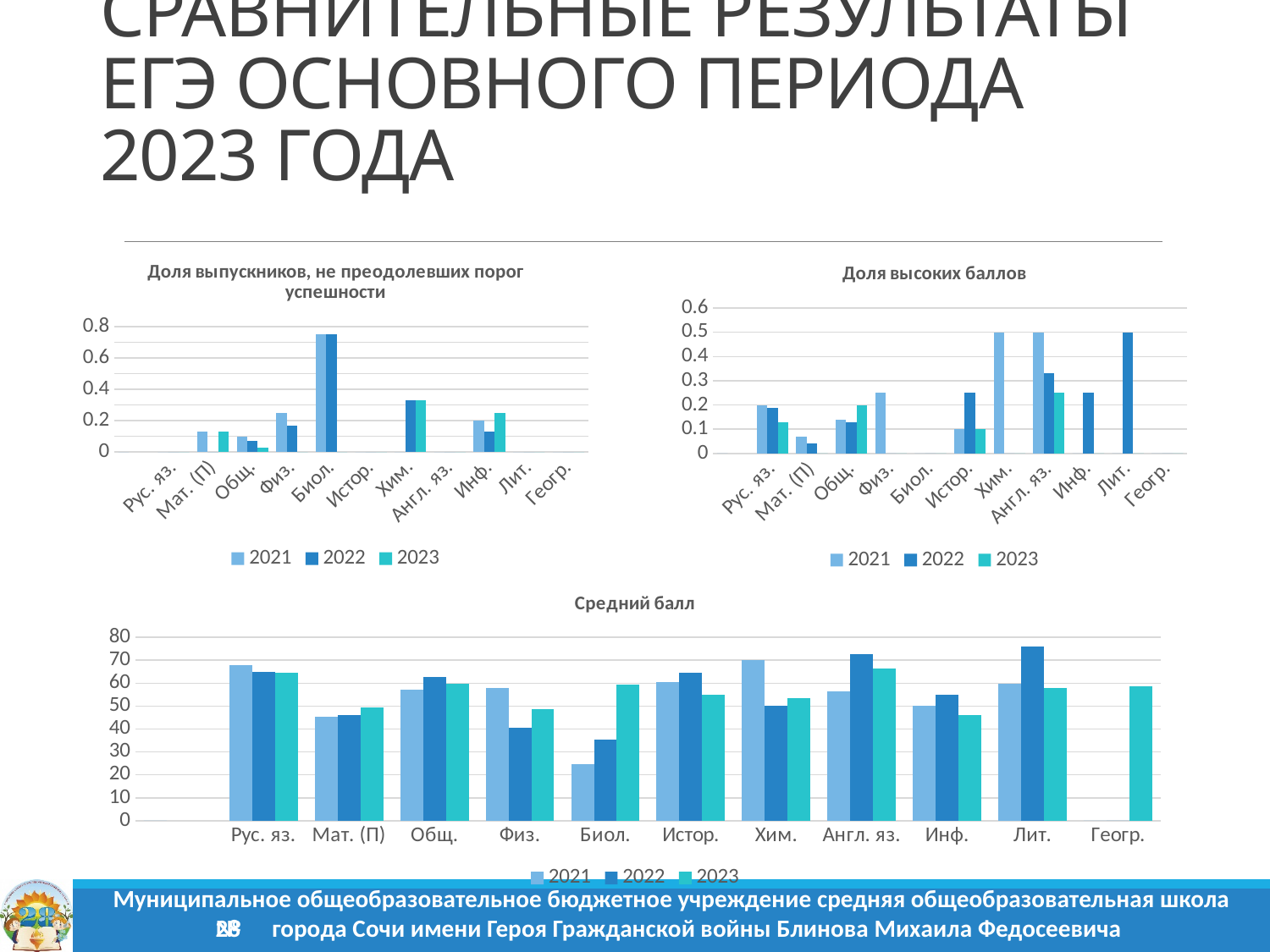
In the "Средний балл" chart, which subject has the lowest bar? Биол. In the "Доля выпускников, не преодолевших порог успешности" chart, is the 2021 value for Биол. greater or less than 0.6? greater In the "Средний балл" chart, do the values for Рус. яз. rise or fall from 2021 to 2023? fall How many series does the legend of the "Средний балл" chart list? 3 How many subject categories are shown on the x axis of the "Средний балл" chart? 11 In the "Доля высоких баллов" chart, is the 2021 value for Хим. greater or less than 0.4? greater In the "Доля высоких баллов" chart, what is the 2022 value for Лит.? 0.5 What kind of chart is the "Средний балл" chart at the bottom of the slide? bar chart In the "Доля выпускников, не преодолевших порог успешности" chart, which subject has the highest bar? Биол. What is the title of the chart in the top-right of the slide? Доля высоких баллов In the "Средний балл" chart, which is larger: the 2021 value for Рус. яз. or the 2021 value for Мат. (П)? Рус. яз. In the "Средний балл" chart, is the 2021 value for Биол. greater or less than 30? less